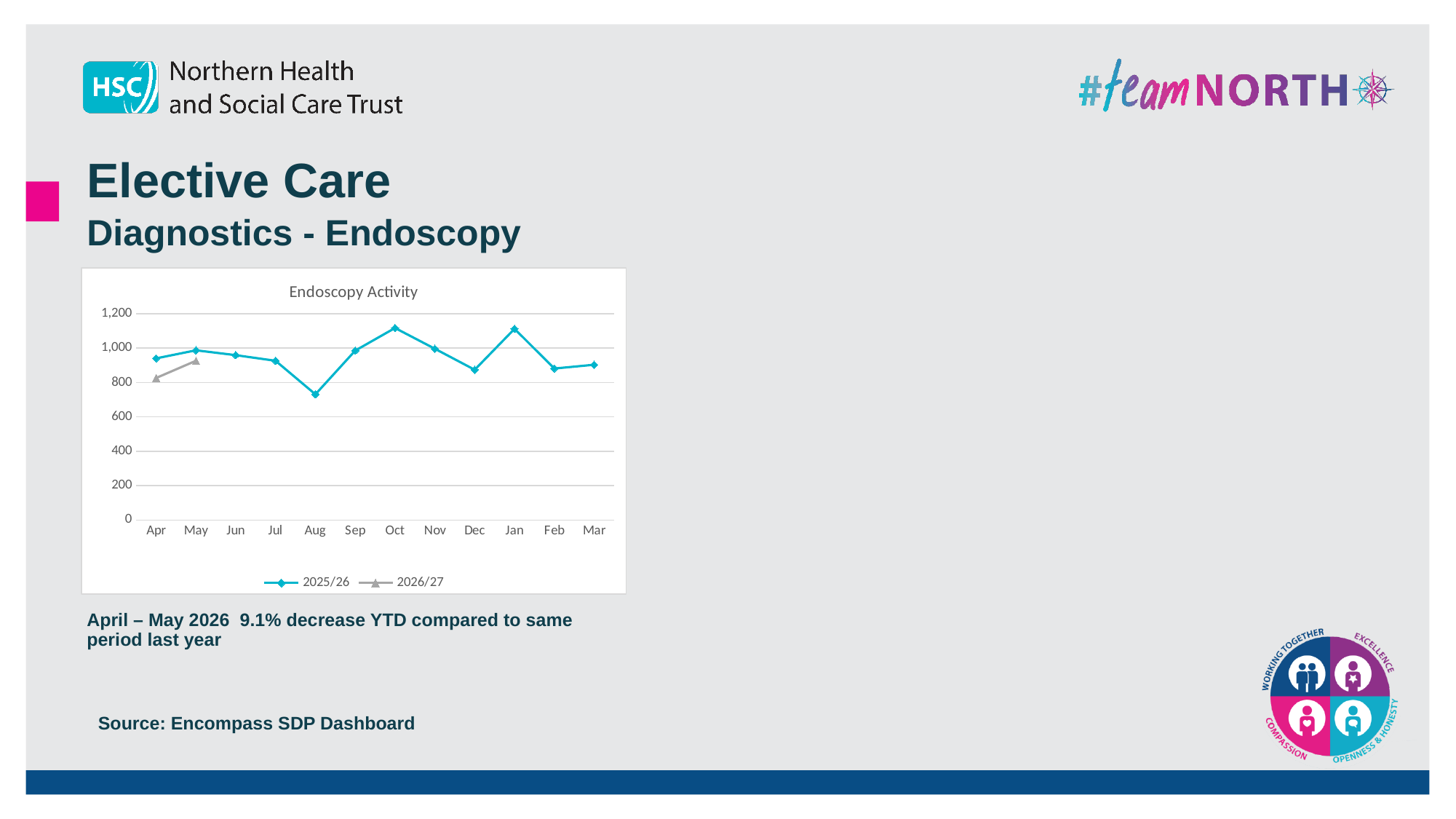
Does the 2025/26 series rise or fall from Jul to Aug? Fall Is the 2025/26 value for Aug greater or less than 800? less What kind of chart is shown on the slide? Line chart Is the 2026/27 value for Apr greater or less than 1,000? less Which two series are listed in the chart legend? 2025/26 and 2026/27 What is the title of the chart? Endoscopy Activity How many data points are plotted for the 2026/27 series? 2 For Apr, which series has the higher value, 2025/26 or 2026/27? 2025/26 How many series does the chart legend list? 2 Which month has the lowest value for the 2025/26 series? Aug How many months are shown on the x axis of the chart? 12 Is the 2025/26 value for Oct greater or less than 1,000? greater